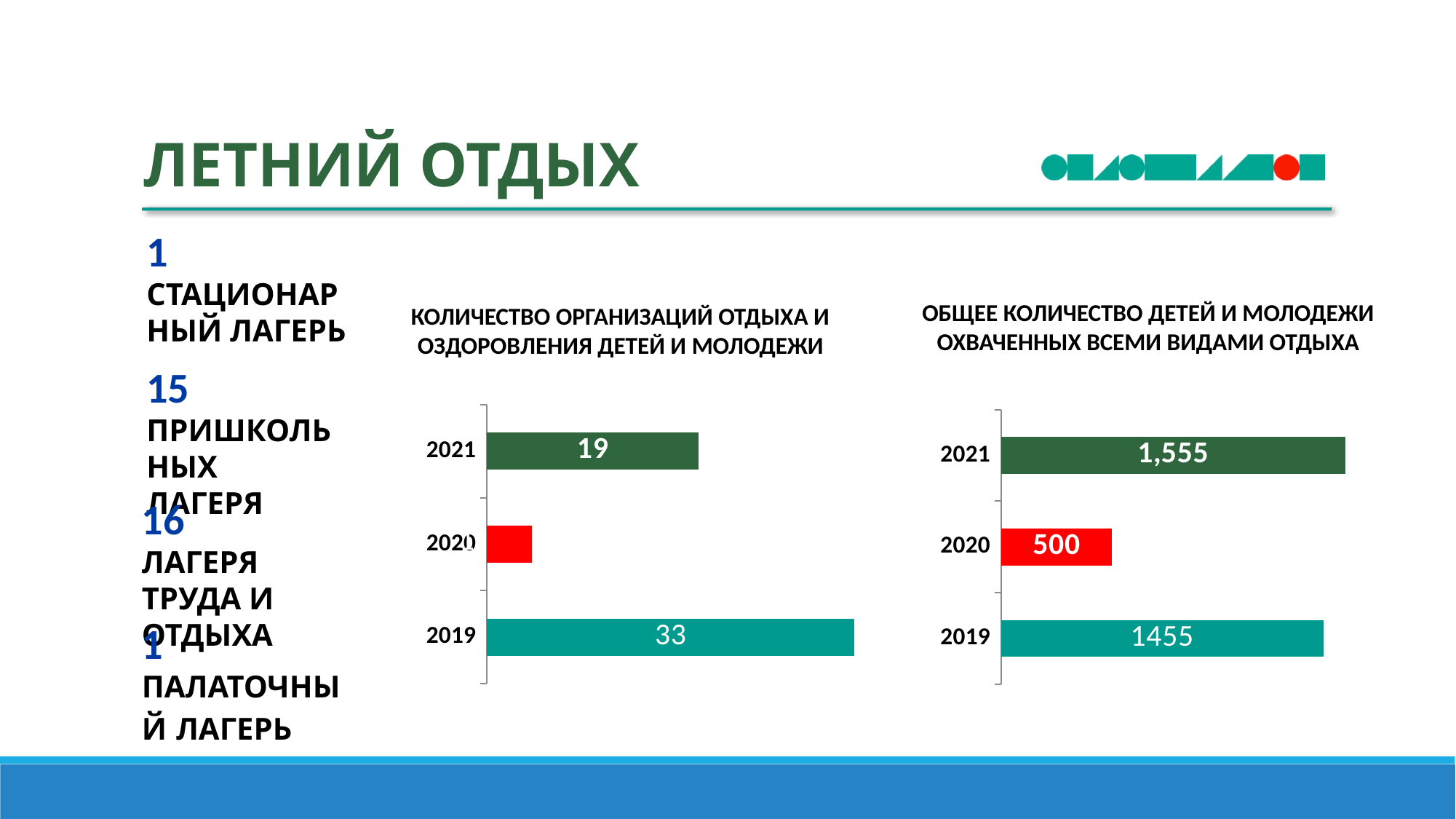
In the right chart (total number of children and youth), what is the value for 2020? 500 In the right chart (total number of children and youth), what is the value for 2021? 1,555 In the right chart (total number of children and youth), what is the value for 2019? 1455 In the left chart (number of recreation organizations), which year has the highest value? 2019 In the left chart (number of recreation organizations), what is the value for 2019? 33 In the left chart (number of recreation organizations), what is the value for 2021? 19 What type of chart is the right chart (total number of children and youth)? Bar chart In the left chart (number of recreation organizations), which year has the lowest value? 2020 In the right chart (total number of children and youth), which year has the lowest value? 2020 In the right chart (total number of children and youth), what is the difference between the 2021 and 2019 values? 100 In the right chart (total number of children and youth), which is larger, the value for 2021 or the value for 2019? 2021 In the left chart (number of recreation organizations), what is the difference between the 2019 and 2021 values? 14